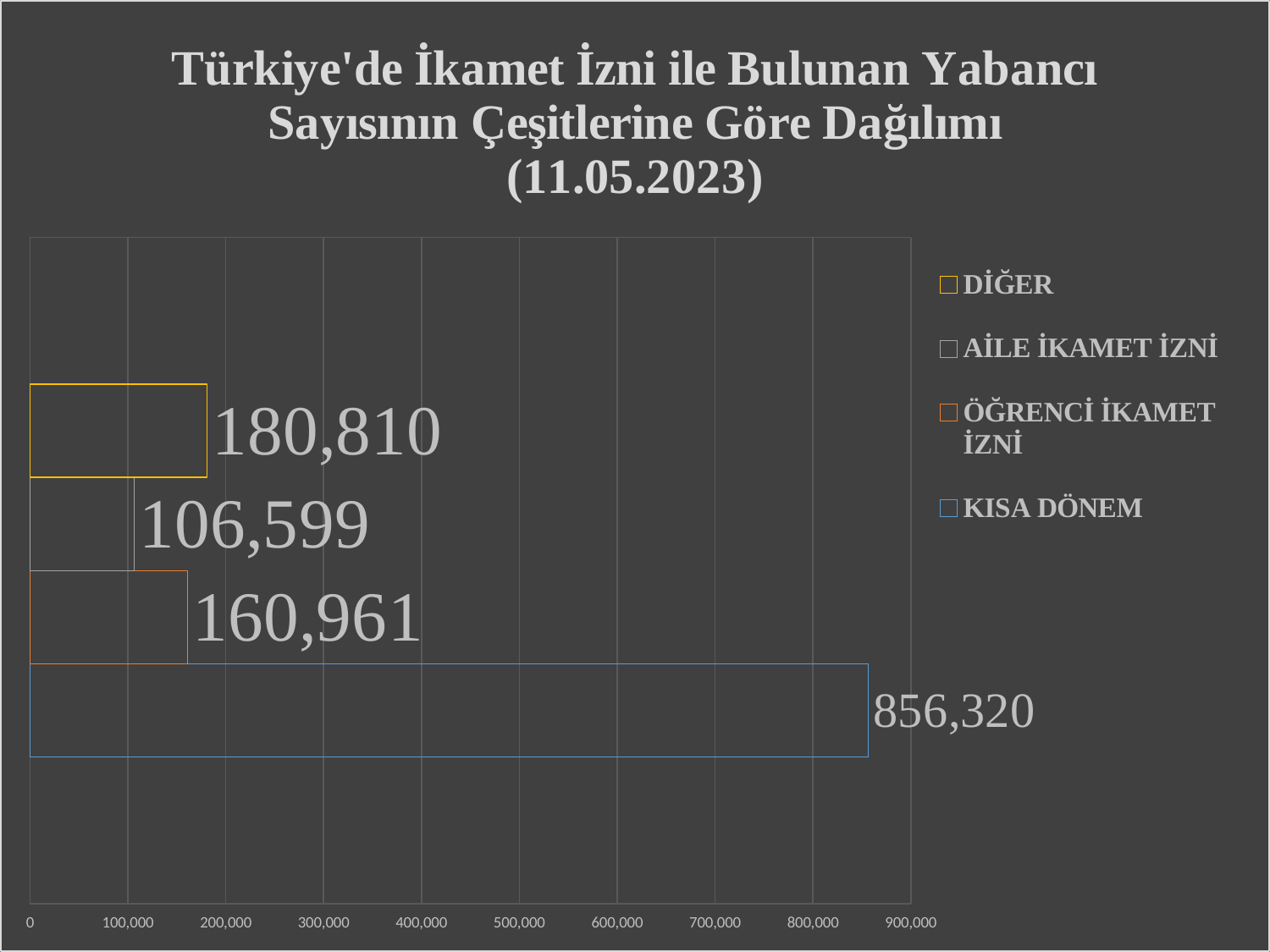
What date is given in the chart title? 11.05.2023 Which residence permit type has the highest value? KISA DÖNEM What is the value for KISA DÖNEM? 856,320 What is the value for ÖĞRENCİ İKAMET İZNİ? 160,961 What is the difference between the values for DİĞER and ÖĞRENCİ İKAMET İZNİ? 19,849 Which residence permit type has the lowest value? AİLE İKAMET İZNİ How many series does the legend list? 4 What kind of chart is shown on the slide? Bar chart Which is larger, the value for ÖĞRENCİ İKAMET İZNİ or the value for AİLE İKAMET İZNİ? ÖĞRENCİ İKAMET İZNİ What is the value for AİLE İKAMET İZNİ? 106,599 What is the value for DİĞER? 180,810 What is the difference between the values for KISA DÖNEM and DİĞER? 675,510